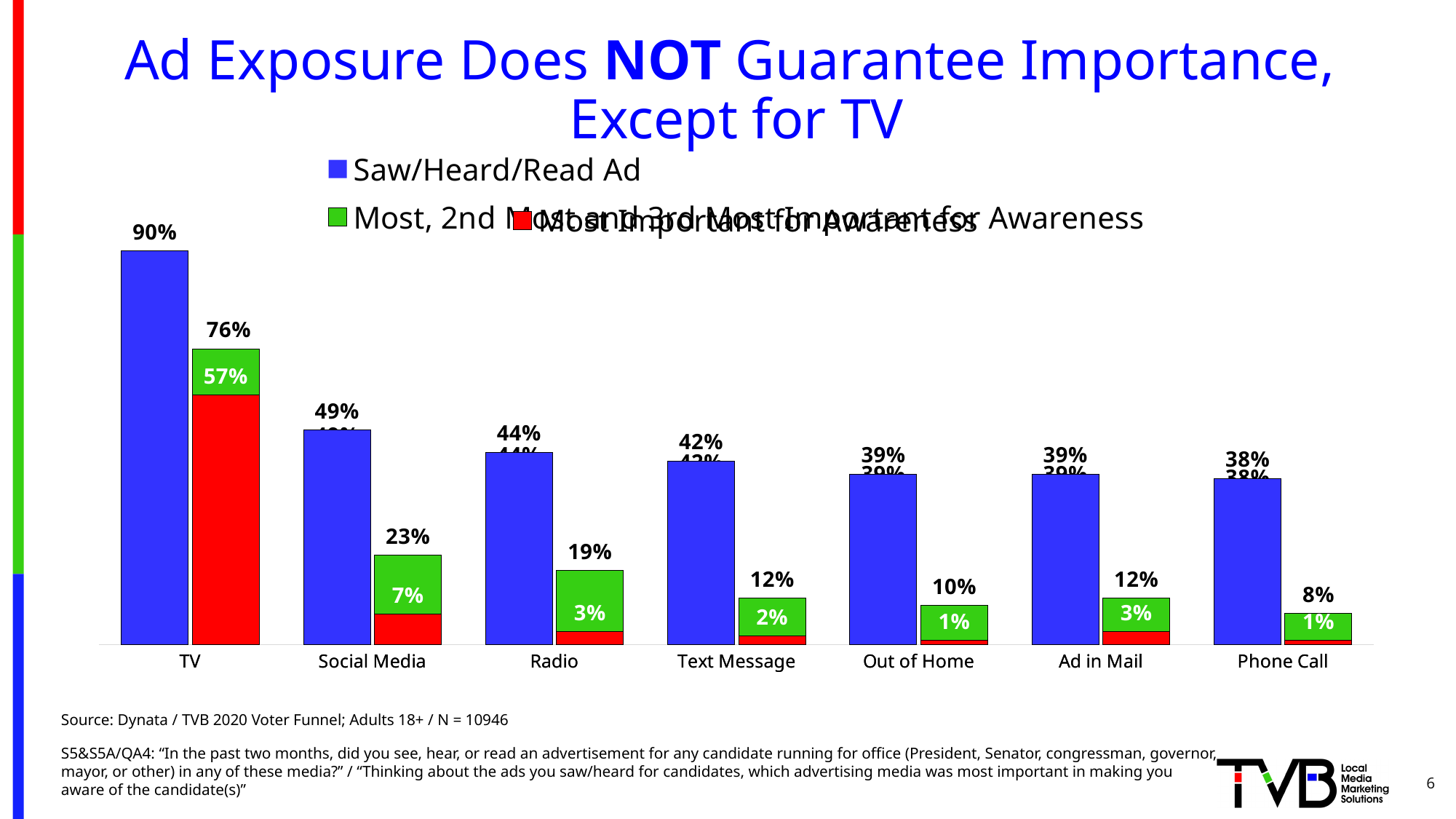
How many media categories are shown on the x axis? 7 What value is labeled at the top of the green bar for Phone Call? 8% What kind of chart is shown on the slide? Bar chart Which has a higher Saw/Heard/Read Ad value, Radio or Text Message? Radio What is the Most Important for Awareness value (red segment) for Ad in Mail? 3% What is the Saw/Heard/Read Ad value for Social Media? 49% What is the Saw/Heard/Read Ad value for TV? 90% What is the difference between the Saw/Heard/Read Ad values for TV and Social Media? 41 percentage points Which medium has the highest Saw/Heard/Read Ad value? TV Which medium has the lowest Saw/Heard/Read Ad value? Phone Call What is the Most Important for Awareness value (red segment) for TV? 57% How many series does the legend list? 3